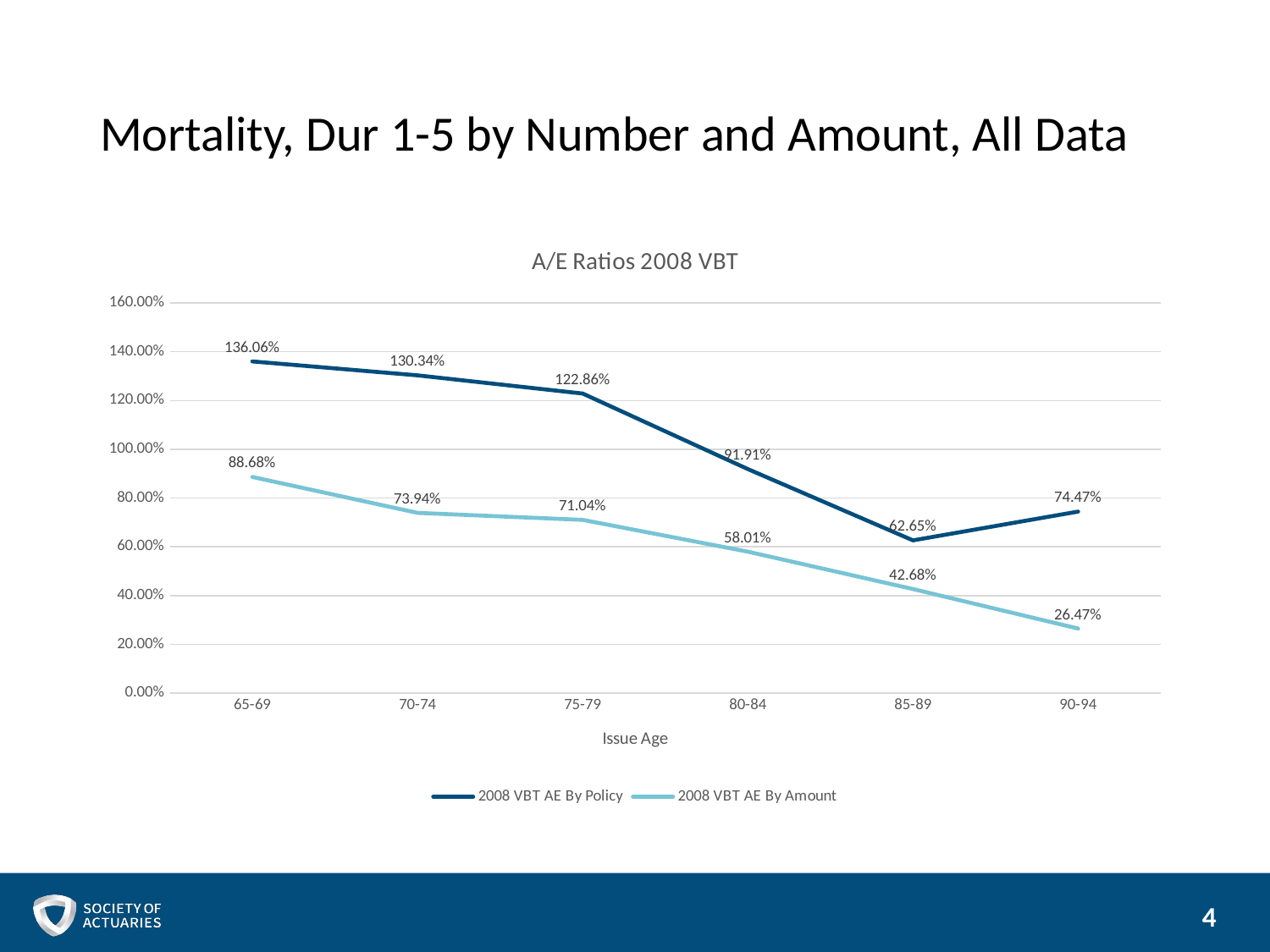
What is the difference between the 2008 VBT AE By Policy and 2008 VBT AE By Amount values for issue age 80-84? 33.90% What is the title of the chart? A/E Ratios 2008 VBT Which is larger for issue age 70-74: 2008 VBT AE By Policy or 2008 VBT AE By Amount? 2008 VBT AE By Policy How many issue age categories are shown on the x axis? 6 Which issue age has the highest 2008 VBT AE By Amount value? 65-69 How many series does the legend list? 2 What is the 2008 VBT AE By Policy value for issue age 85-89? 62.65% What kind of chart is shown on the slide? Line chart Which issue age has the lowest 2008 VBT AE By Policy value? 85-89 Does the 2008 VBT AE By Amount series rise or fall from issue age 65-69 to 90-94? Fall What is the 2008 VBT AE By Policy value for issue age 65-69? 136.06% What is the 2008 VBT AE By Amount value for issue age 90-94? 26.47%